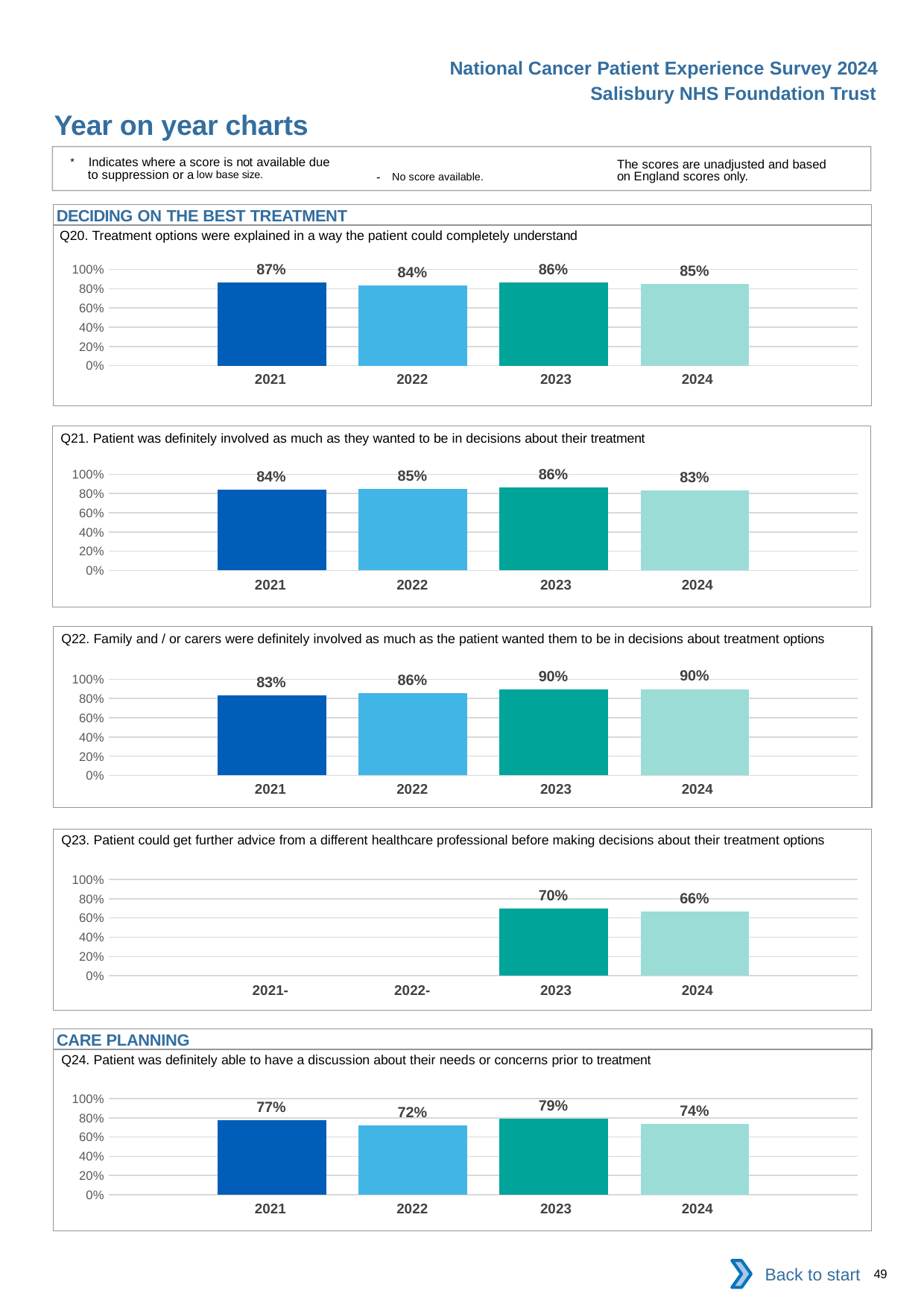
In the Q21 chart (Patient was definitely involved as much as they wanted to be in decisions about their treatment), which year has the highest value? 2023 What kind of chart is used for Q20? bar chart In the Q20 chart, how many years are shown on the x axis? 4 In the Q20 chart (Treatment options were explained in a way the patient could completely understand), what is the value for 2021? 87% In the Q22 chart (Family and / or carers were definitely involved as much as the patient wanted them to be), what is the difference between the 2024 and 2021 values? 7 percentage points In the Q24 chart, what is the difference between the 2023 and 2022 values? 7 percentage points In the Q24 chart (Patient was definitely able to have a discussion about their needs or concerns prior to treatment), which is larger, the 2022 value or the 2024 value? 2024 In the Q22 chart, do the values rise or fall from 2021 to 2024? rise In the Q21 chart, which year has the lowest value? 2024 In the Q23 chart (Patient could get further advice from a different healthcare professional), what is the value for 2024? 66% In the Q23 chart, how many years have a bar plotted? 2 In the Q24 chart, what is the value for 2023? 79%